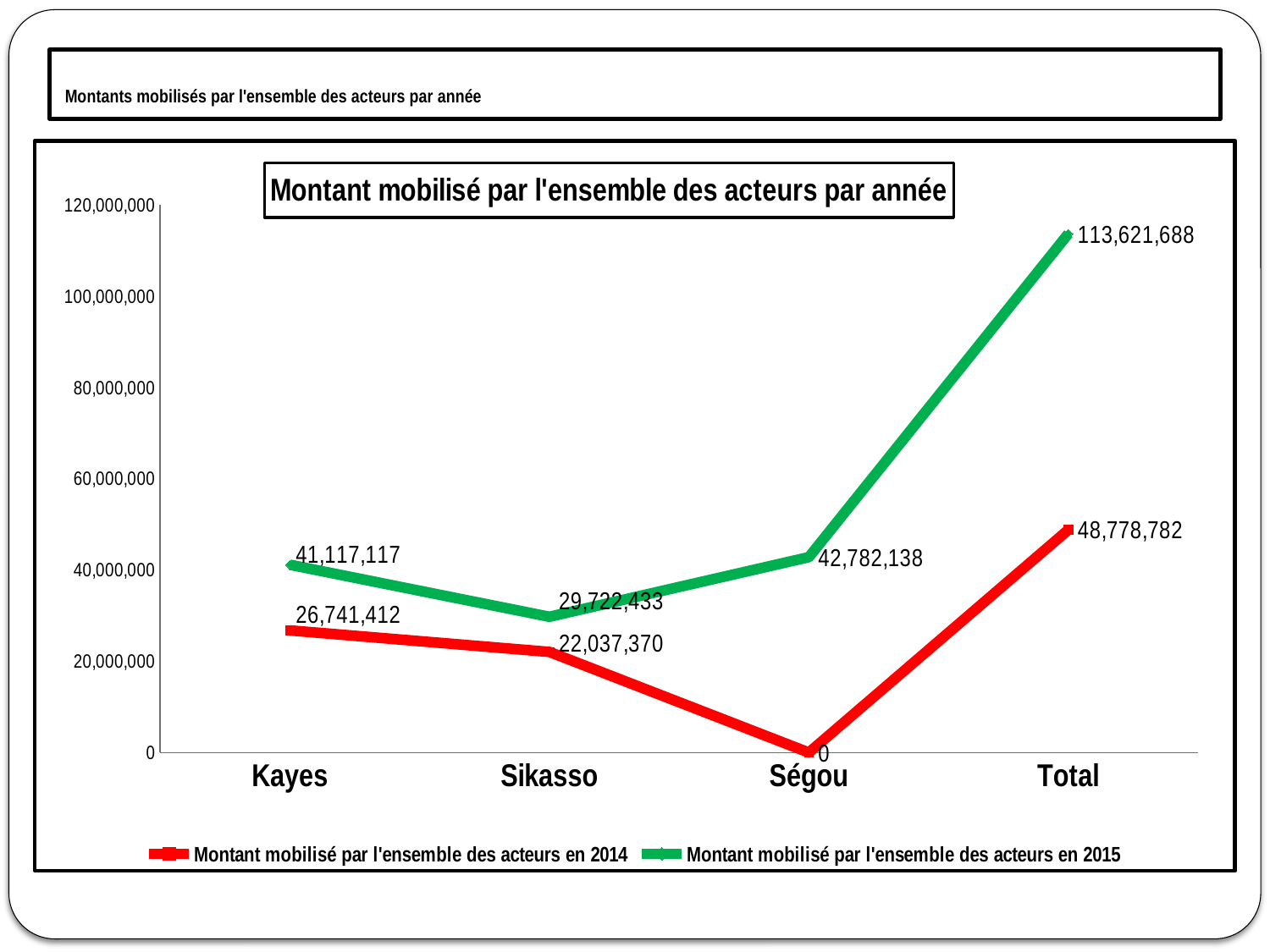
What is the difference between the 2015 and 2014 values for Kayes? 14,375,705 What type of chart is shown on the slide? line chart What is the value of the 2015 series for Sikasso? 29,722,433 How many series does the legend list? 2 What is the amount mobilised by all actors in 2014 for Kayes? 26,741,412 What is the amount mobilised by all actors in 2015 for Ségou? 42,782,138 How many categories are shown on the x axis? 4 Among the regions Kayes, Sikasso and Ségou, which has the lowest value in the 2014 series? Ségou Among the regions Kayes, Sikasso and Ségou, which has the highest value in the 2015 series? Ségou What is the difference between the 2015 and 2014 Total values? 64,842,906 Which is larger for Sikasso: the 2014 value or the 2015 value? the 2015 value What is the value of the 2014 series for Ségou? 0